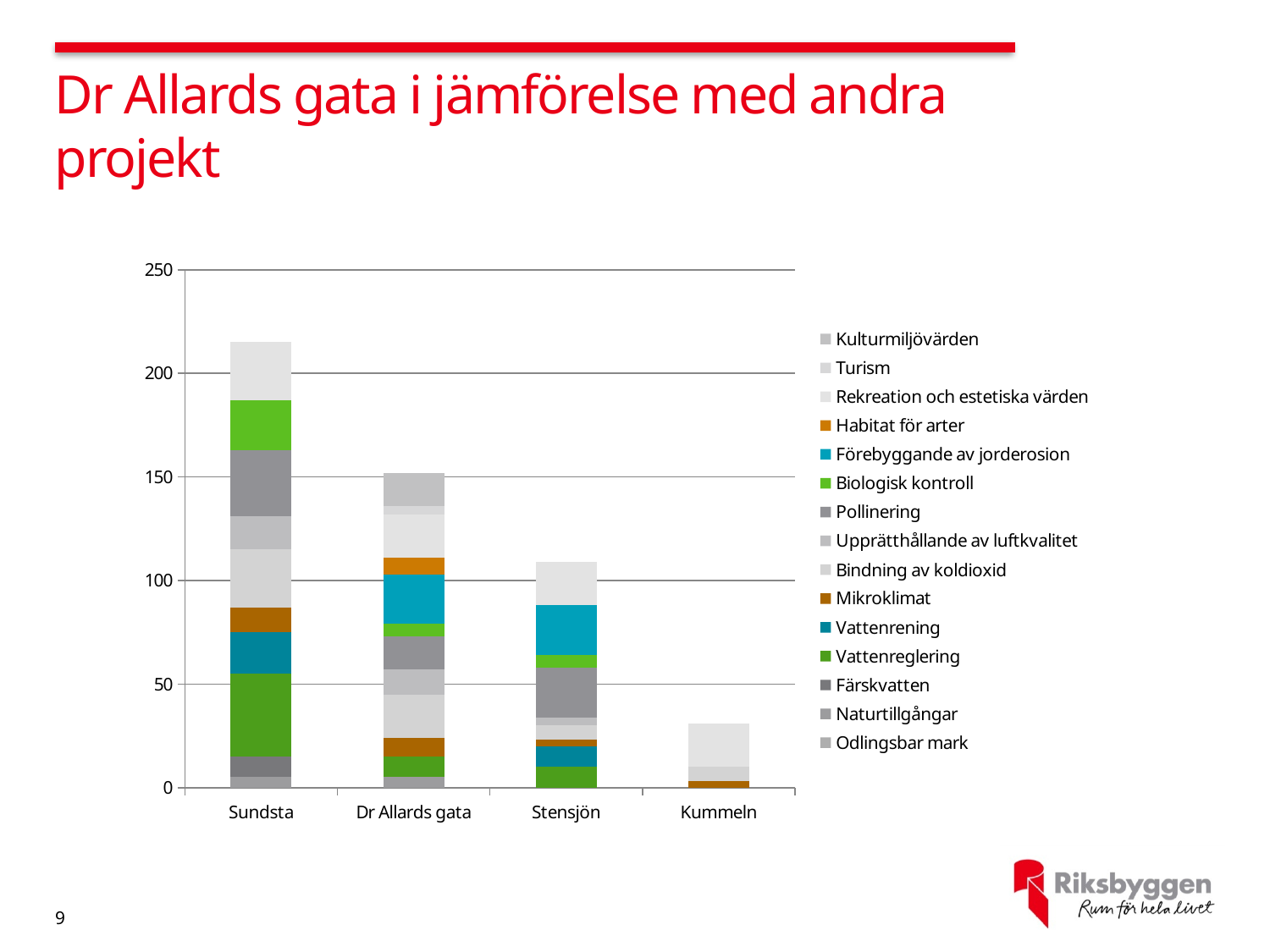
Do the stacked bar totals rise or fall from left to right along the x axis? fall Which stacked bar is taller, Dr Allards gata or Stensjön? Dr Allards gata How many projects (categories) are shown on the x axis? 4 Is the total for Kummeln greater or less than 50? less Which project has the shortest stacked bar? Kummeln Which project has the tallest stacked bar? Sundsta Which legend entry is listed first (at the top of the legend)? Kulturmiljövärden How many series does the legend list? 15 What kind of chart is shown on the slide? Stacked bar chart What is the title of the slide? Dr Allards gata i jämförelse med andra projekt Is the total for Sundsta greater or less than 200? greater